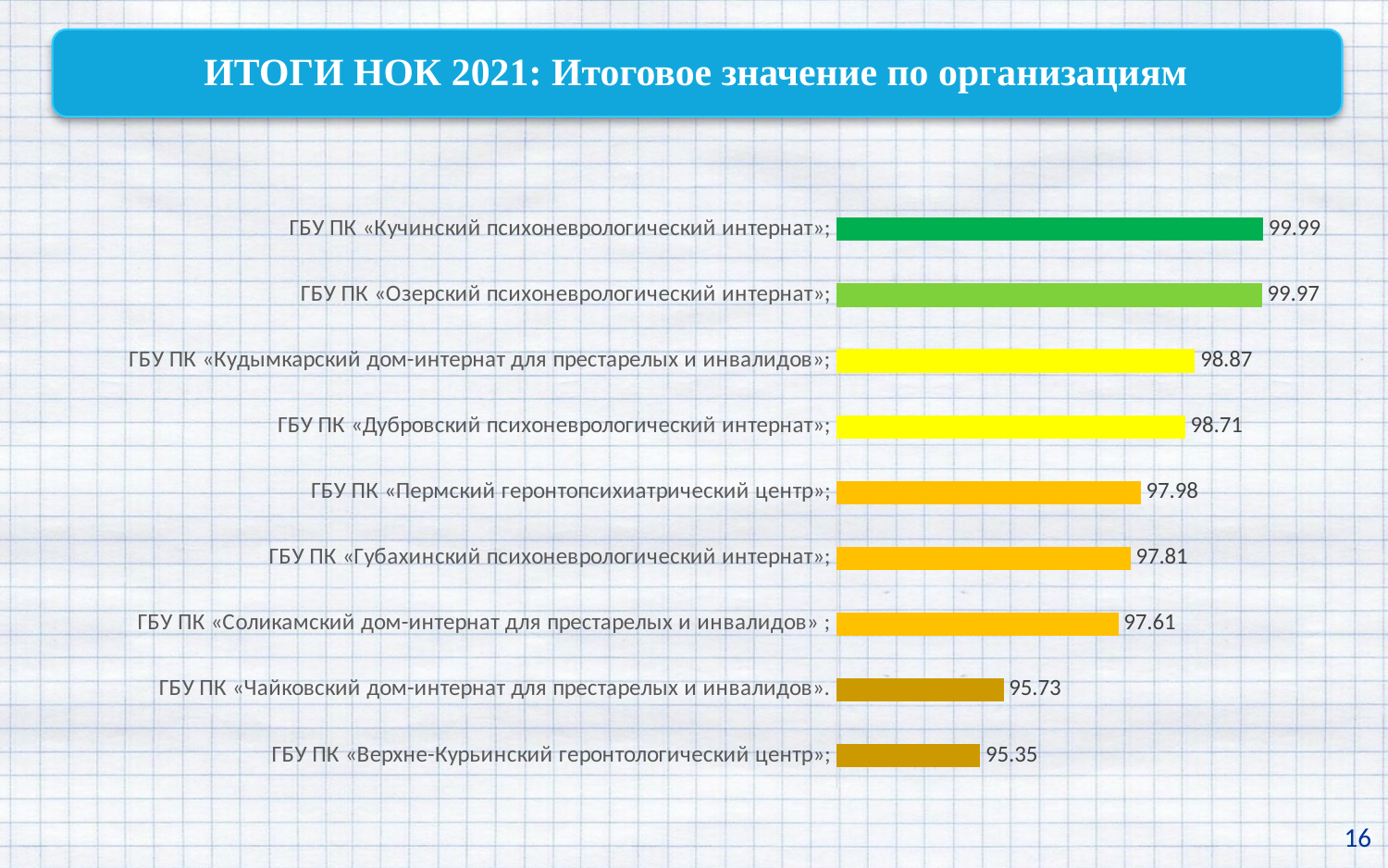
Which organisation has the highest value? ГБУ ПК «Кучинский психоневрологический интернат» How many organisations are shown in the chart? 9 Which has a larger value: ГБУ ПК «Губахинский психоневрологический интернат» or ГБУ ПК «Соликамский дом-интернат для престарелых и инвалидов»? ГБУ ПК «Губахинский психоневрологический интернат» What is the difference between the values for ГБУ ПК «Кудымкарский дом-интернат для престарелых и инвалидов» and ГБУ ПК «Дубровский психоневрологический интернат»? 0.16 What kind of chart is shown on the slide? Bar chart What is the value for ГБУ ПК «Пермский геронтопсихиатрический центр»? 97.98 What is the title of the slide? ИТОГИ НОК 2021: Итоговое значение по организациям What colour is the bar for ГБУ ПК «Озерский психоневрологический интернат»? Light green What is the value for ГБУ ПК «Кучинский психоневрологический интернат»? 99.99 Which organisation has the lowest value? ГБУ ПК «Верхне-Курьинский геронтологический центр» What is the value for ГБУ ПК «Чайковский дом-интернат для престарелых и инвалидов»? 95.73 What is the difference between the values for ГБУ ПК «Кучинский психоневрологический интернат» and ГБУ ПК «Верхне-Курьинский геронтологический центр»? 4.64